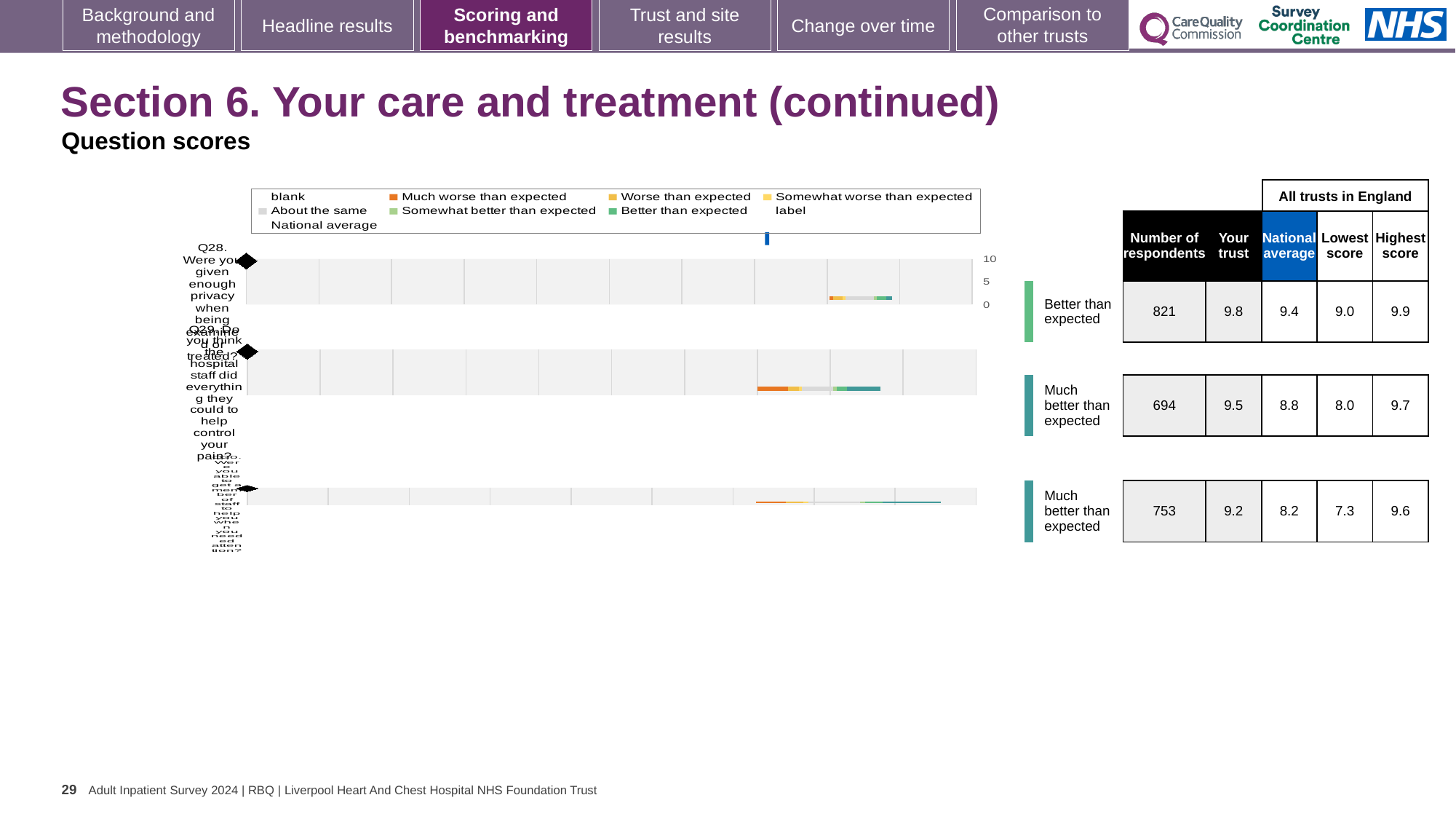
How many questions (rows) are plotted in the question scores chart? 3 What kind of chart is used to show the question scores on this slide? bar chart What benchmark category is shown for Q29? Much better than expected How many respondents answered Q30? 753 Which of the three questions has the lowest national average score? Q30 What is the difference between the 'Your trust' score and the national average for Q29? 0.7 What is the highest score among all trusts in England for Q28? 9.9 What is the national average score for Q29 (Do you think the hospital staff did everything they could to help control your pain?)? 8.8 Which of the three questions has the highest 'Your trust' score? Q28 What is the lowest score among all trusts in England for Q30? 7.3 Is the 'Your trust' score for Q30 higher or lower than the national average for Q30? higher What is the 'Your trust' score for Q28 (Were you given enough privacy when being examined or treated?)? 9.8